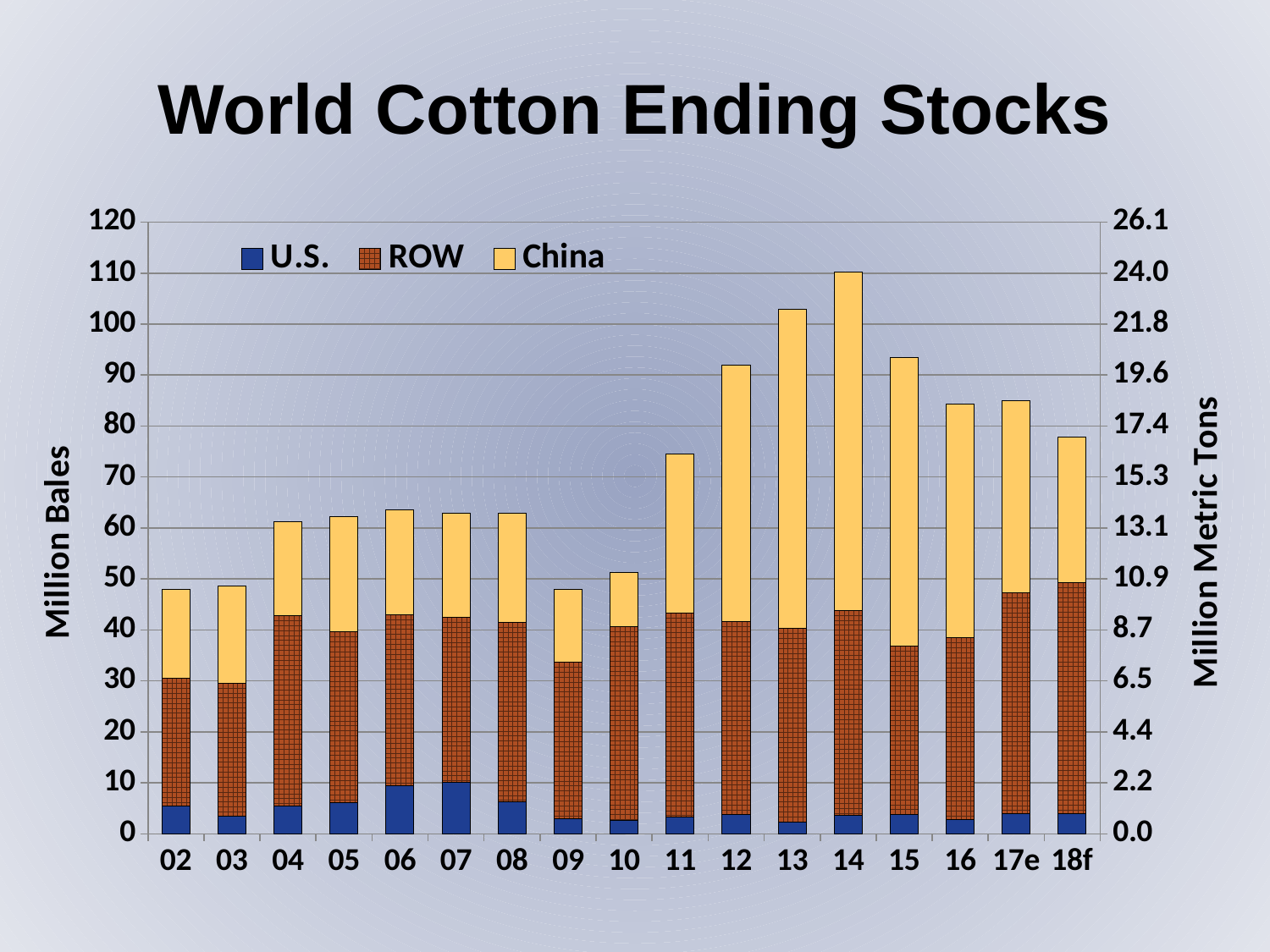
How many series does the legend list? 3 What is the label of the left vertical axis? Million Bales Is the total stacked bar for 11 greater or less than 70 million bales? greater What kind of chart is shown on the slide? Stacked bar chart What are the three series named in the legend? U.S., ROW, China Is the total stacked bar for 16 greater or less than 90 million bales? less Do total ending stocks rise or fall from 11 to 14? rise Is the total stacked bar for 09 greater or less than 50 million bales? less How many years (categories) are shown on the x axis? 17 Which year has the highest total world cotton ending stocks? 14 Which year has the larger total ending stocks, 12 or 13? 13